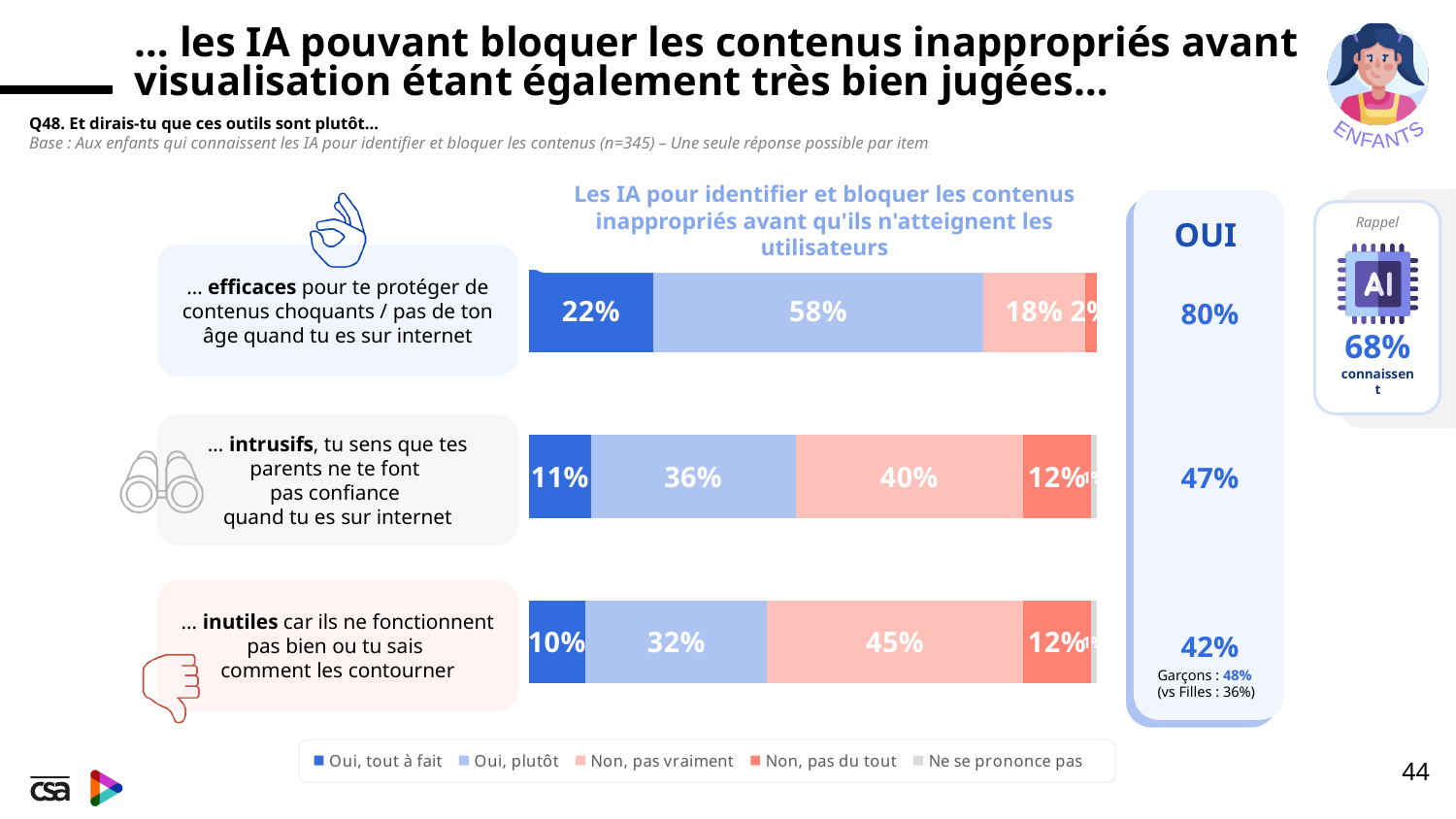
What type of chart is shown on the slide? stacked bar chart Which item has the highest 'Oui, tout à fait' value? … efficaces pour te protéger de contenus choquants How many series does the legend list? 5 What is the 'Non, pas vraiment' value for the item '… inutiles'? 45% Which is larger: the 'Non, pas vraiment' value for '… intrusifs' or for '… inutiles'? … inutiles Which item has the lowest total 'OUI' value shown in the OUI column? … inutiles How many items (categories) are plotted in the chart? 3 What is the 'Non, pas vraiment' value for the item '… intrusifs'? 40% What is the difference between the 'Oui, plutôt' values for '… efficaces' and '… intrusifs'? 22% What is the 'Oui, plutôt' value for the item '… efficaces pour te protéger de contenus choquants'? 58% What is the 'Non, pas du tout' value for the item '… inutiles'? 12% What is the 'Oui, tout à fait' value for the item '… efficaces pour te protéger de contenus choquants'? 22%